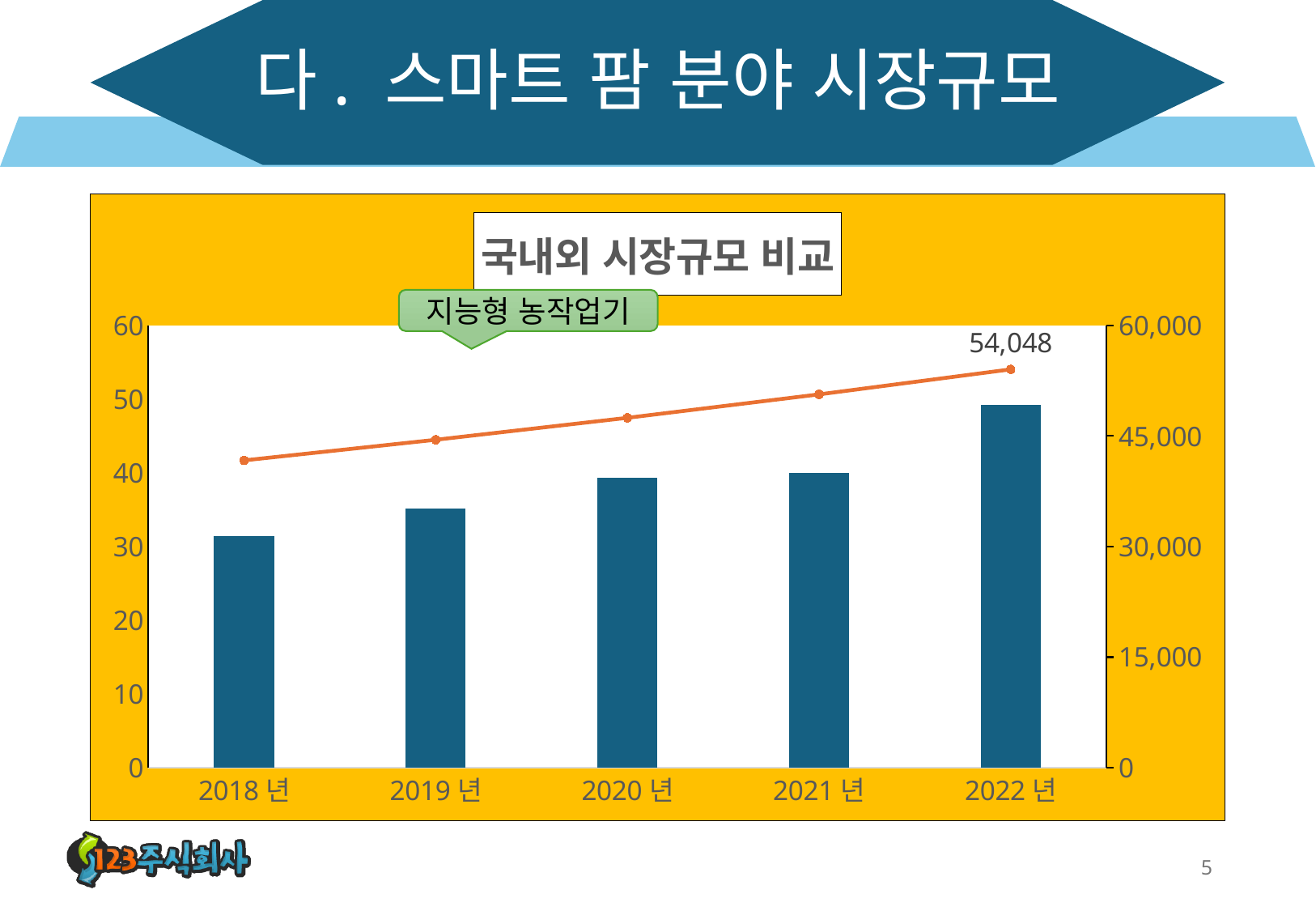
How many years are shown on the x axis? 5 What value is labelled on the line at 2022 년? 54,048 Which bar is taller, 2018 년 or 2022 년? 2022 년 Is the bar value for 2018 년 greater or less than 40 on the left axis? less Do the bar values rise or fall from 2018 년 to 2022 년? rise Which year has the tallest bar? 2022 년 What text is shown in the green callout above the chart? 지능형 농작업기 Is the bar value for 2022 년 greater or less than 40 on the left axis? greater What kind of chart is shown? bar chart with a line Which year has the shortest bar? 2018 년 What is the title of the chart? 국내외 시장규모 비교 Does the line rise or fall from 2018 년 to 2022 년? rise